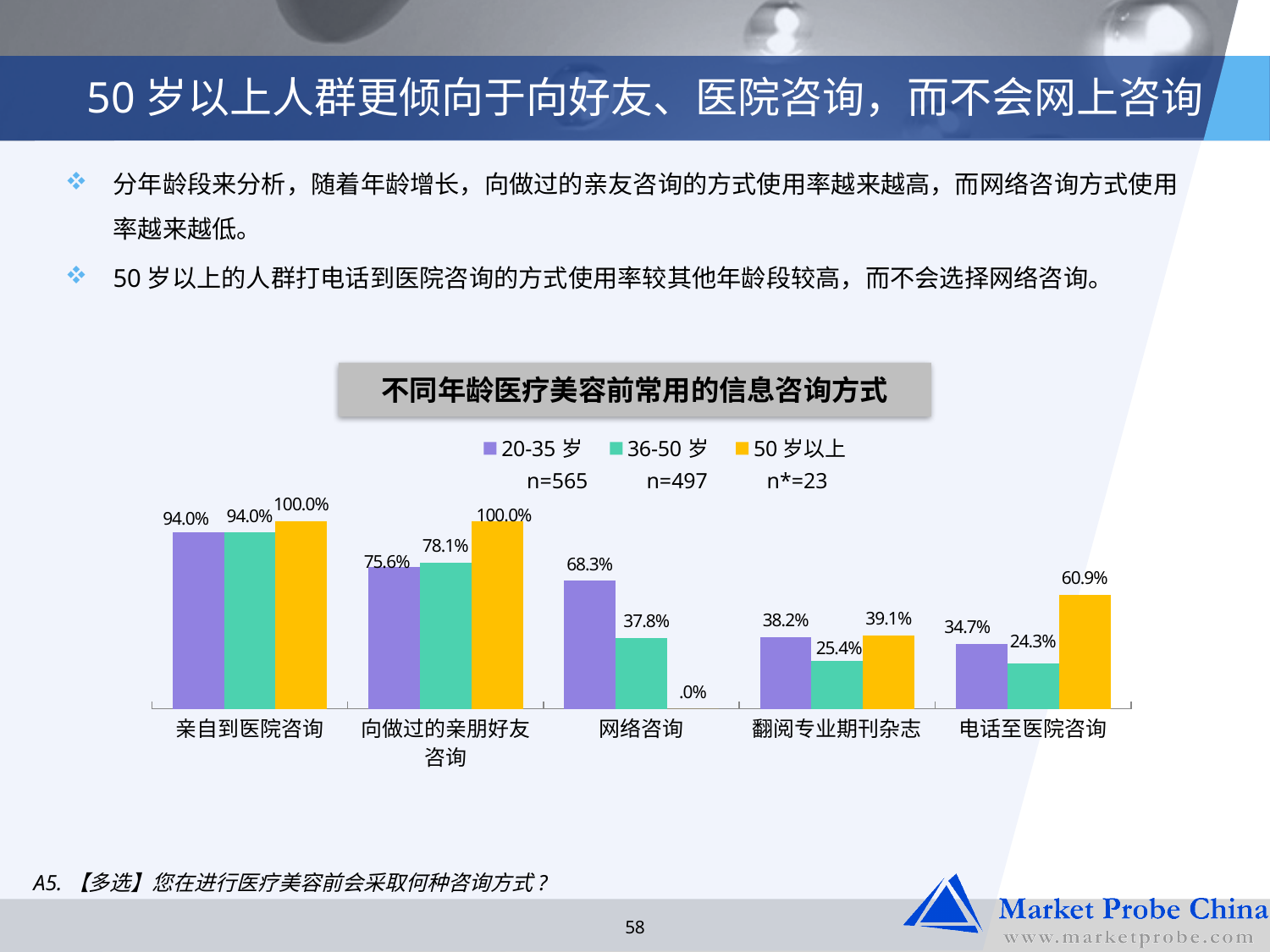
What is the value for 20-35 岁 in the 网络咨询 category? 68.3% What type of chart is shown on the slide? bar chart What is the value for 36-50 岁 in the 向做过的亲朋好友咨询 category? 78.1% What is the sample size (n) shown for the 36-50 岁 series? n=497 In the 电话至医院咨询 category, which series has the larger value: 20-35 岁 or 50 岁以上? 50 岁以上 What is the difference between the 20-35 岁 and 36-50 岁 values in the 网络咨询 category? 30.5% Which category has the highest value for the 20-35 岁 series? 亲自到医院咨询 How many categories are shown on the x axis? 5 Which category has the lowest value for the 36-50 岁 series? 电话至医院咨询 What is the value for 50 岁以上 in the 电话至医院咨询 category? 60.9% How many series does the legend list? 3 What is the value for 50 岁以上 in the 网络咨询 category? .0%